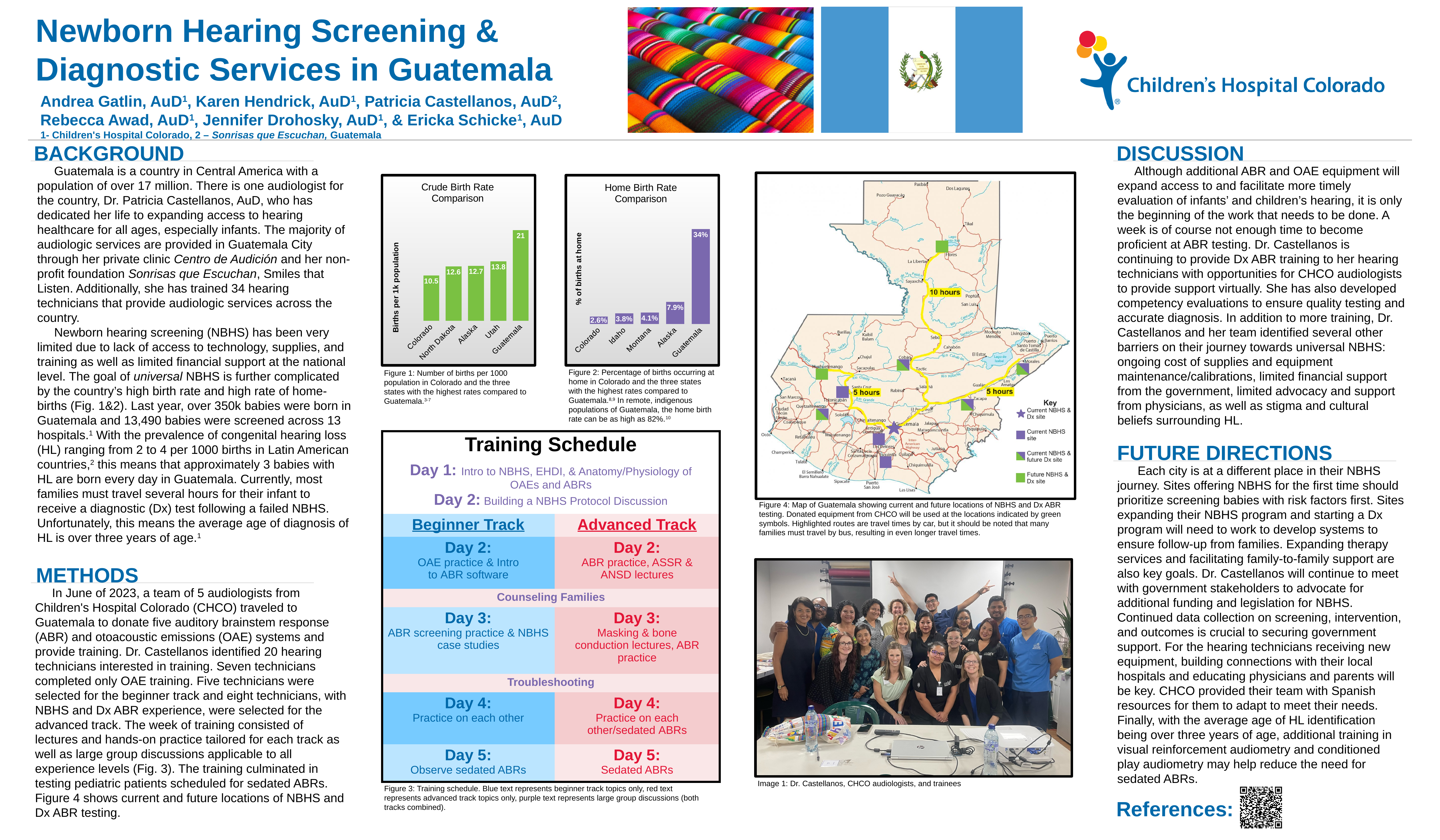
In the Crude Birth Rate Comparison chart, what is the value for Guatemala? 21 In the Crude Birth Rate Comparison chart, what is the value for Colorado? 10.5 What is the y-axis label of the Home Birth Rate Comparison chart? % of births at home In the Home Birth Rate Comparison chart, what is the value for Guatemala? 34% In the Home Birth Rate Comparison chart, which is larger, Idaho or Montana? Montana In the Home Birth Rate Comparison chart, what is the value for Alaska? 7.9% In the Home Birth Rate Comparison chart, which category has the highest value? Guatemala What kind of chart is the Crude Birth Rate Comparison chart? Bar chart In the Crude Birth Rate Comparison chart, how many categories are shown? 5 In the Home Birth Rate Comparison chart, what is the difference between Guatemala and Colorado? 31.4% In the Crude Birth Rate Comparison chart, what is the difference between Guatemala and Utah? 7.2 In the Crude Birth Rate Comparison chart, which category has the lowest value? Colorado